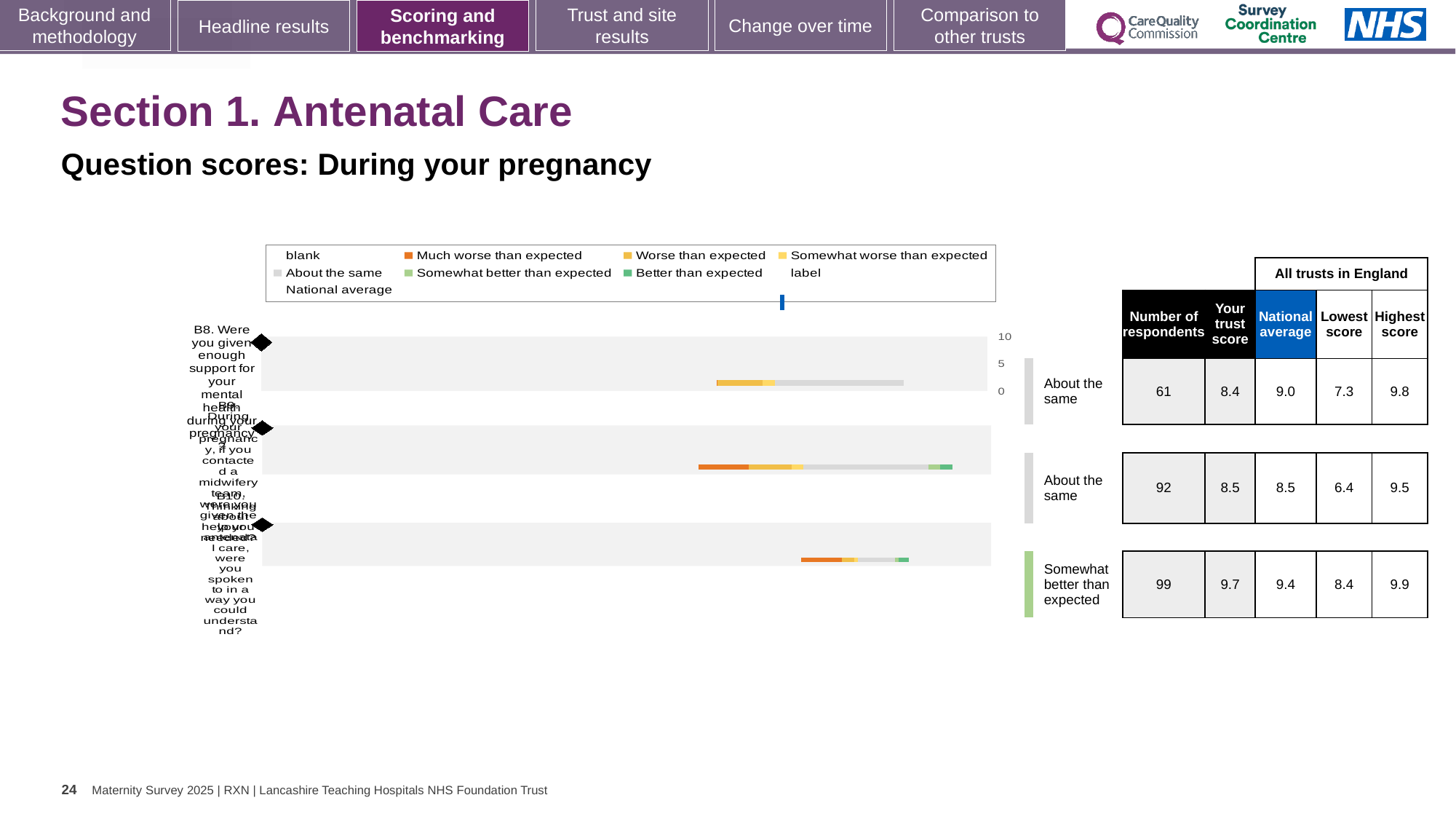
Which row has the lowest 'Lowest score' value among all trusts in England? The second (middle) row, 6.4 Which row of the chart has the highest trust score? The third (bottom) row, 9.7 What is the subtitle describing the chart on this slide? Question scores: During your pregnancy How many questions (rows) are plotted in the chart? 3 What is the national average for question B8, the first row of the chart? 9.0 What benchmark category is given for the third (bottom) row of the chart? Somewhat better than expected What is the trust score for question B8 (Were you given enough support for your mental health during your pregnancy?)? 8.4 What kind of chart is used to show the question scores on this slide? Bar chart How many respondents are listed for the third (bottom) row of the chart? 99 For the third (bottom) row, how much higher is the trust score than the national average? 0.3 For question B8, which is larger: the trust score or the national average? National average What is the difference between the highest score and the lowest score for question B8? 2.5